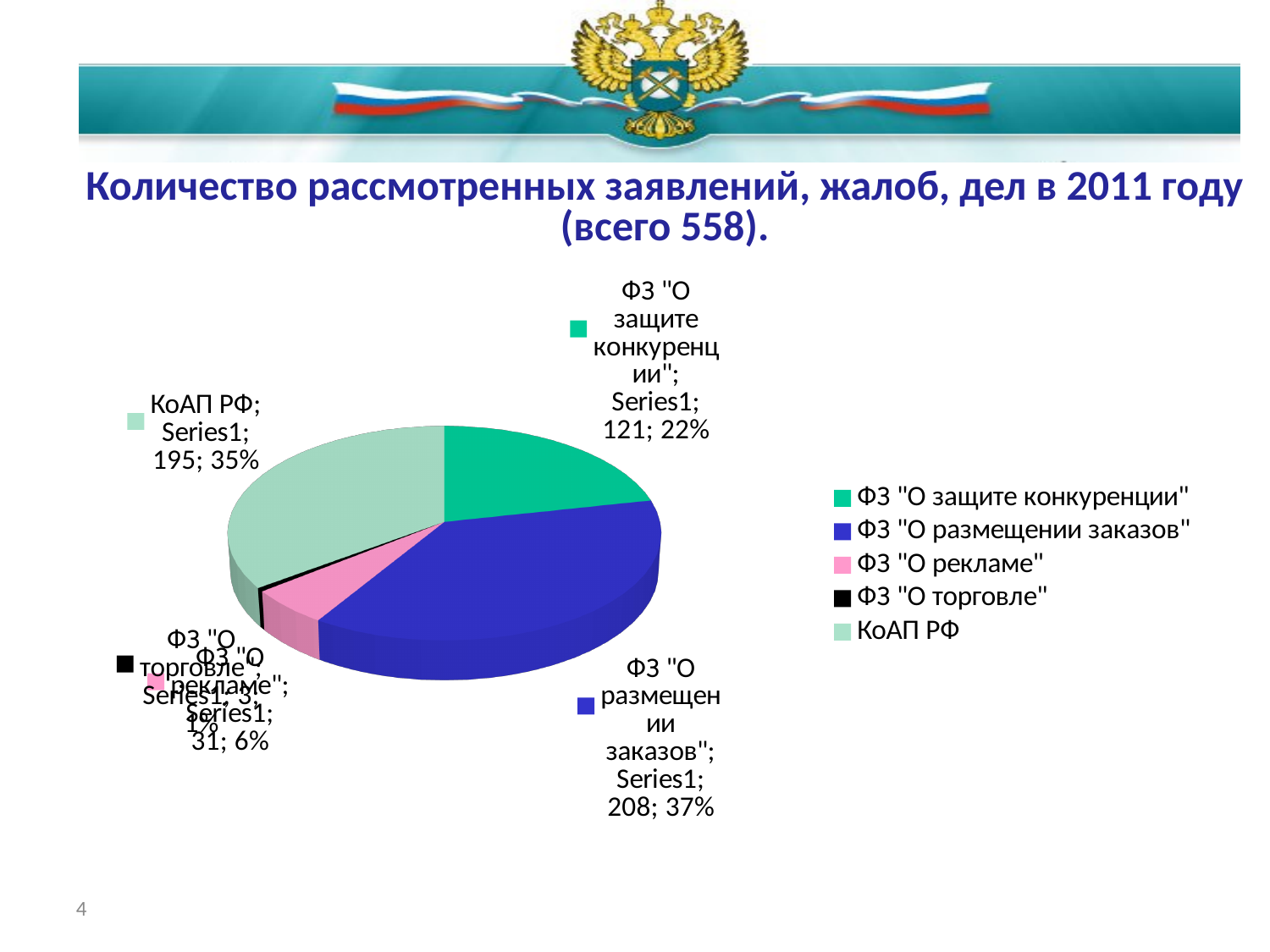
What is the value for ФЗ "О защите конкуренции"? 121 Which category has the smallest slice of the pie? ФЗ "О торговле" What share of the pie does КоАП РФ represent? 35% Which category has the largest slice of the pie? ФЗ "О размещении заказов" What is the value for КоАП РФ? 195 How many slices does the pie chart have? 5 What is the value for ФЗ "О торговле"? 3 What is the difference between the values for ФЗ "О размещении заказов" and КоАП РФ? 13 What kind of chart is shown on the slide? pie chart What is the value for ФЗ "О рекламе"? 31 What is the value for ФЗ "О размещении заказов"? 208 Which is larger, the value for ФЗ "О защите конкуренции" or the value for ФЗ "О рекламе"? ФЗ "О защите конкуренции"